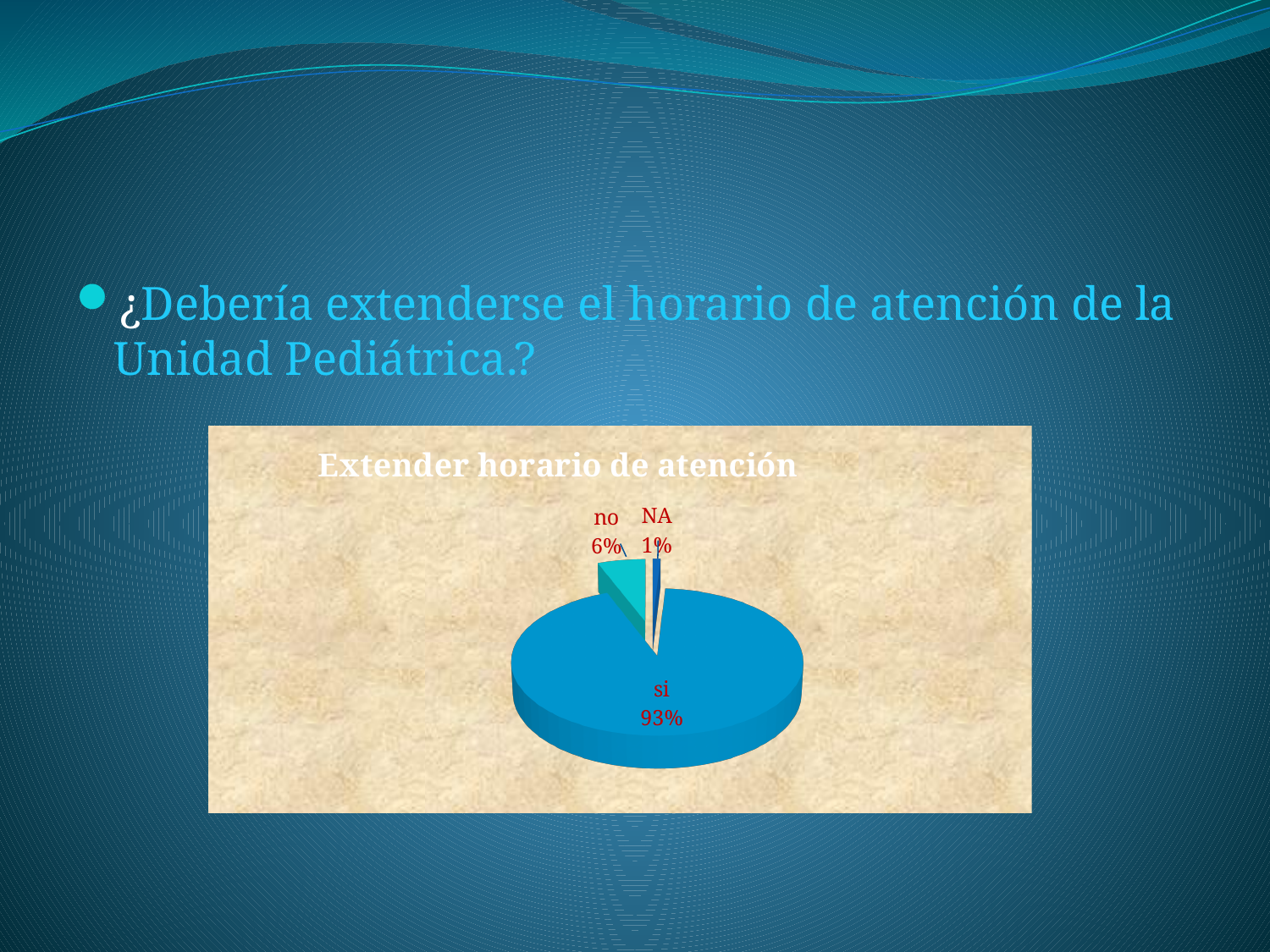
What percentage of the pie is labelled "si"? 93% Which category has the smallest share of the pie? NA What type of chart is shown on the slide? pie chart What is the combined share of the "no" and "NA" slices? 7% How many slices does the pie chart have? 3 What percentage of the pie is labelled "no"? 6% Which slice is larger, "no" or "NA"? no What percentage of the pie is labelled "NA"? 1% What colour is the "si" slice of the pie? blue What is the title of the chart? Extender horario de atención Which category has the largest share of the pie? si What is the difference in percentage points between the "si" and "no" slices? 87